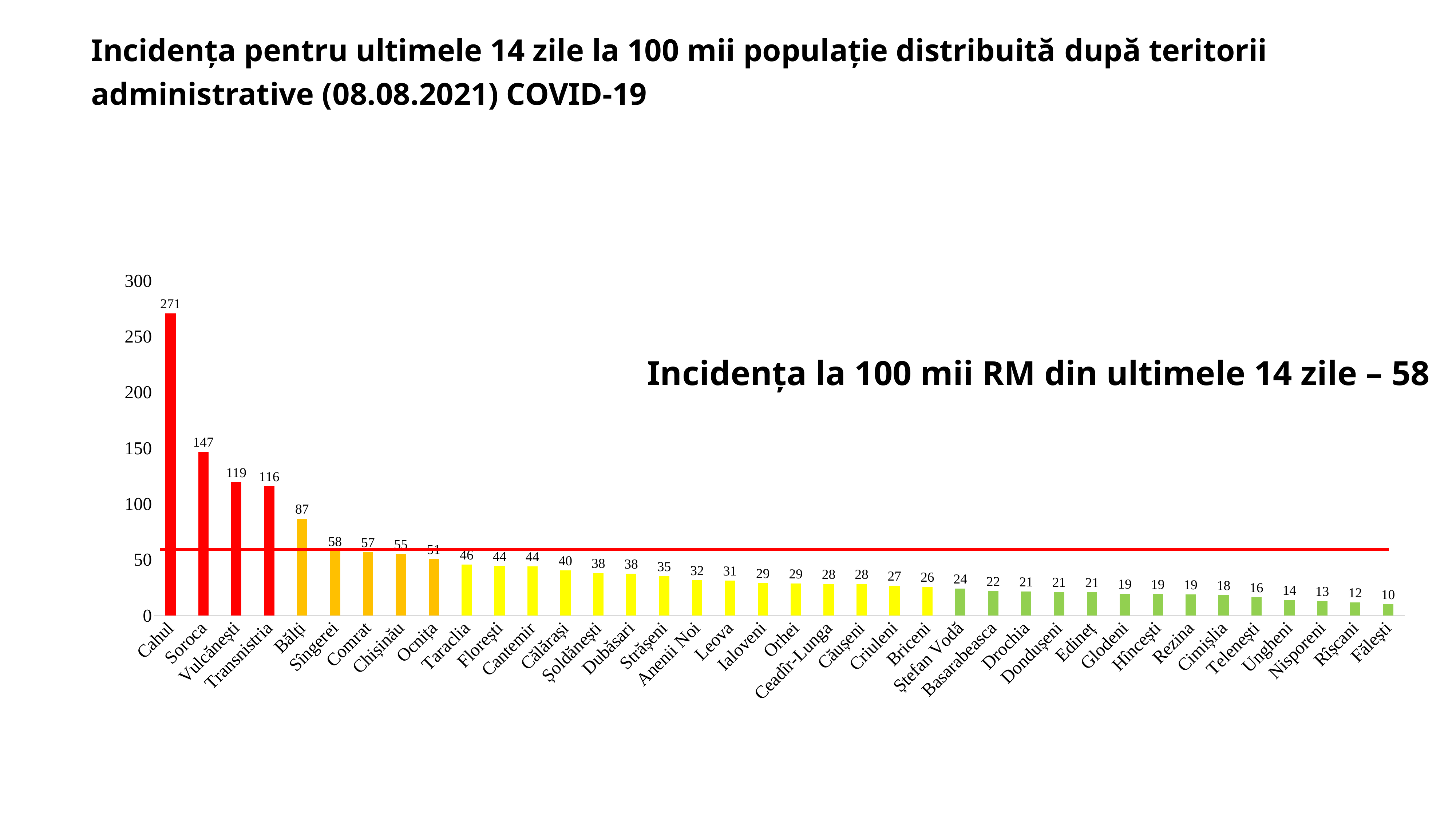
What is the value for Cahul? 271 What kind of chart is shown on the slide? bar chart Which territory has the lowest value? Fălești How many territories are shown on the x axis? 38 Is the value for Soroca greater or less than 100? greater What is the difference between the values for Cahul and Soroca? 124 What national incidence value does the text on the slide state for the last 14 days? 58 What is the value for Chișinău? 55 What is the value for Bălți? 87 Do the values rise or fall from left to right along the x axis? fall Which is larger, the value for Vulcănești or the value for Transnistria? Vulcănești Which territory has the highest value? Cahul